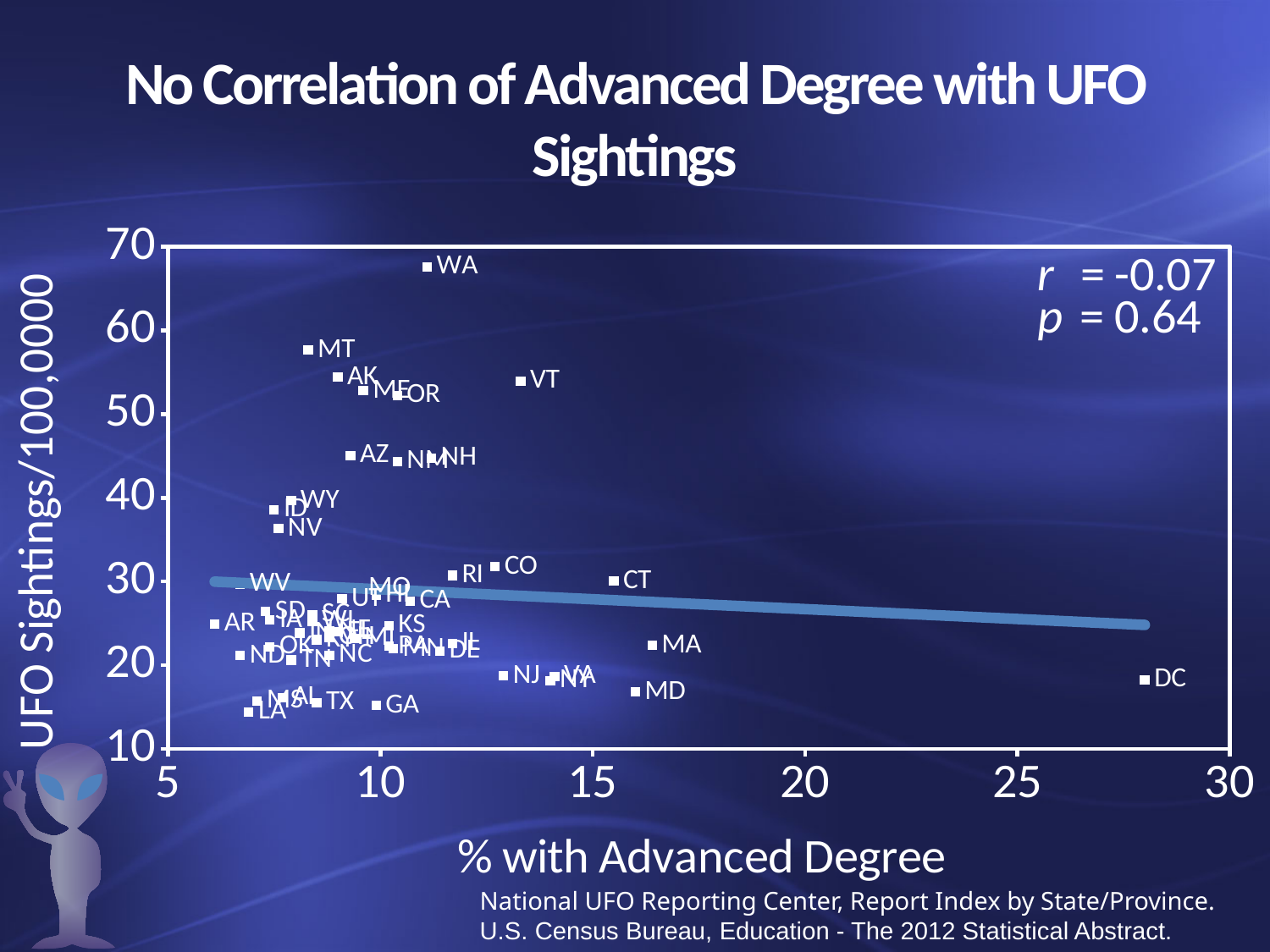
Which state has the highest UFO sightings per 100,000? WA Is the UFO sightings value for WA greater or less than 60? greater What correlation coefficient r is shown on the chart? -0.07 Is the % with advanced degree for DC greater or less than 25? greater Which point has the highest % with advanced degree? DC Which has more UFO sightings per 100,000, WA or MT? WA Which state has the lowest % with advanced degree? AR Does the fitted trend line rise or fall as % with advanced degree increases? fall What kind of chart is shown on the slide? Scatter plot Is the UFO sightings value for AZ greater or less than 40? greater